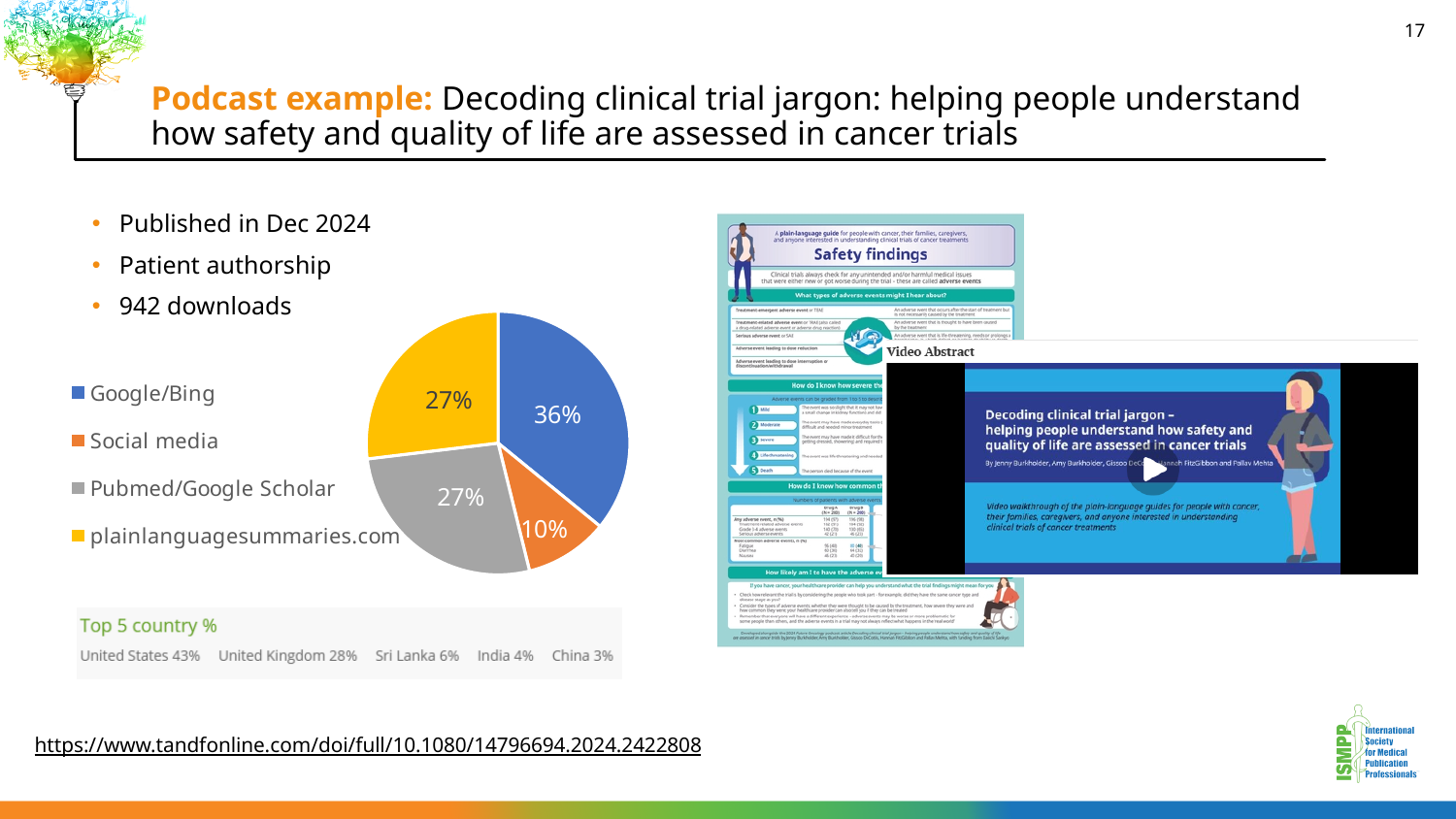
What share of the pie chart does plainlanguagesummaries.com account for? 27% What colour is the Social media slice in the pie chart? orange What share of the pie chart does Pubmed/Google Scholar account for? 27% What kind of chart is shown on the slide? pie chart Which is larger in the pie chart, Google/Bing or Social media? Google/Bing What share of the pie chart does Google/Bing account for? 36% Which category has the smallest slice in the pie chart? Social media Which category has the largest slice in the pie chart? Google/Bing What is the difference in percentage points between the Google/Bing slice and the Social media slice? 26 percentage points How many categories does the pie chart legend list? 4 Which legend entry is shown in yellow in the pie chart? plainlanguagesummaries.com